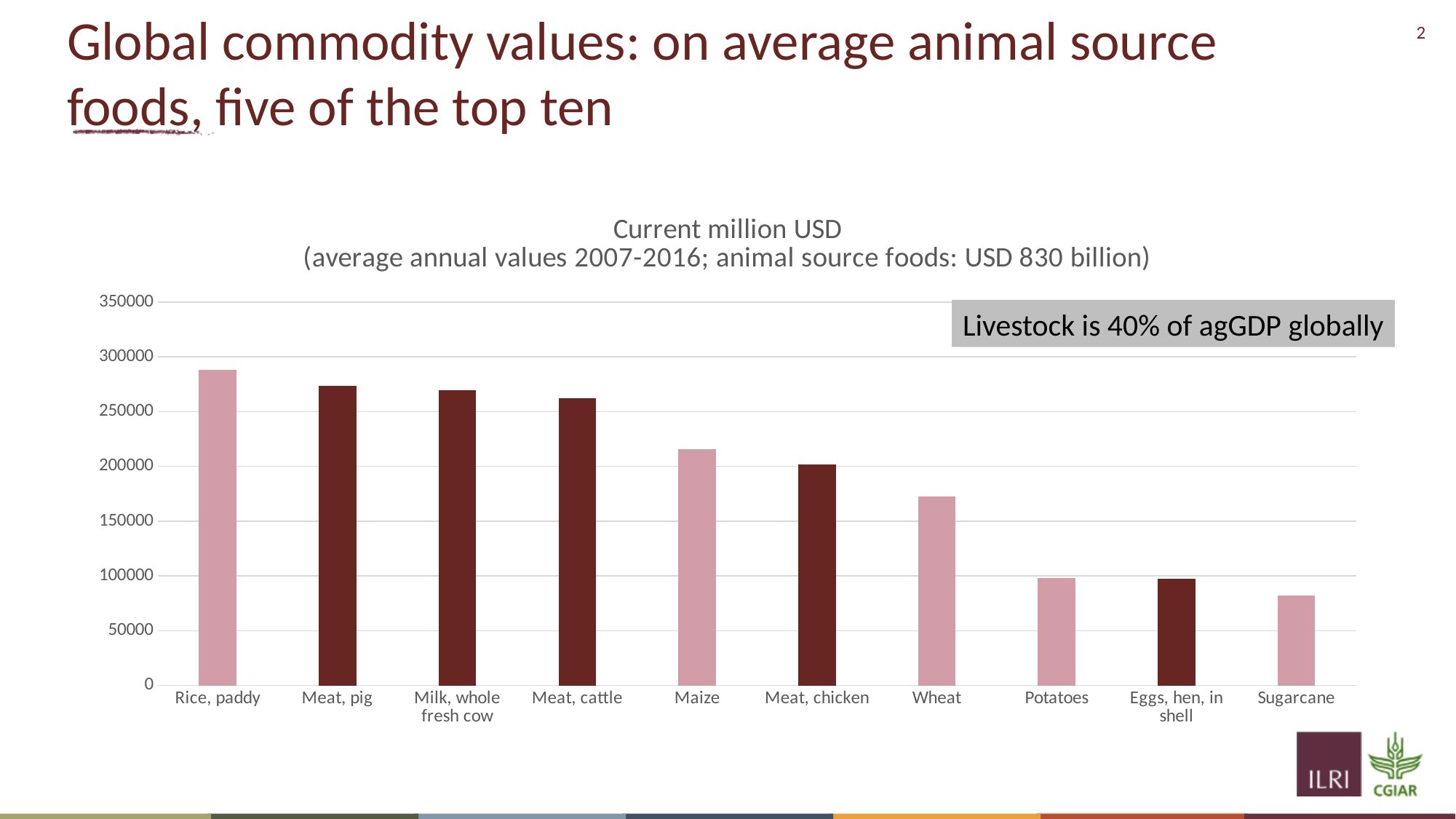
What unit does the chart title say the values are in? Current million USD How many commodity categories are plotted on the chart? 10 Which has a larger value, Meat, chicken or Potatoes? Meat, chicken Which commodity has the highest value on the chart? Rice, paddy Is the value for Rice, paddy greater or less than 250000? greater Do the bar values generally rise or fall from left to right along the x axis? fall Which commodity has the lowest value on the chart? Sugarcane Is the value for Sugarcane greater or less than 100000? less Is the value for Meat, cattle greater or less than 250000? greater What kind of chart is shown on the slide? bar chart Which has a larger value, Maize or Wheat? Maize